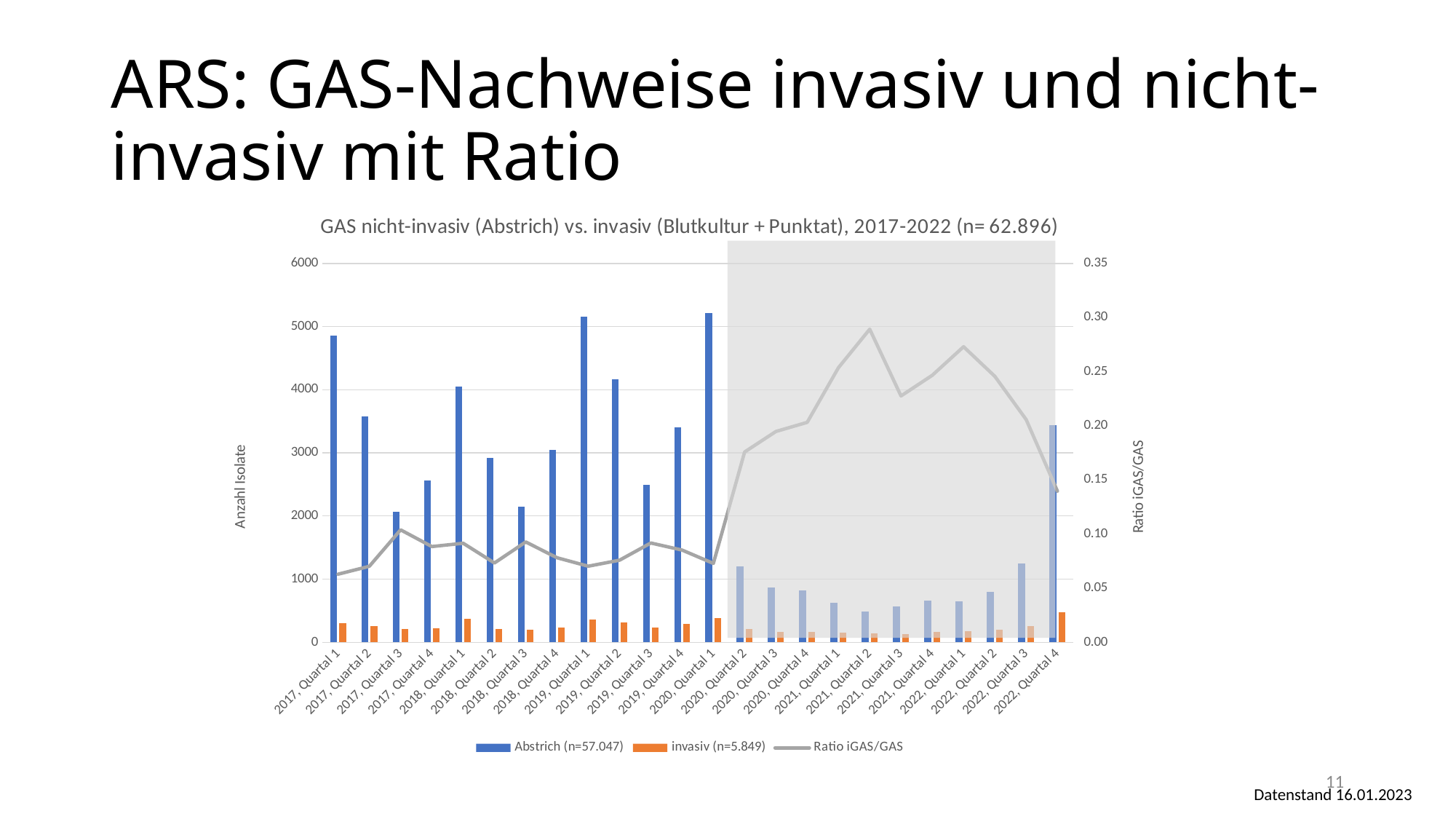
Is the Ratio iGAS/GAS value for 2021, Quartal 2 greater or less than 0.25? greater In which quarter is the Ratio iGAS/GAS line at its highest? 2021, Quartal 2 Is the Abstrich value for 2017, Quartal 1 greater or less than 4000? greater Which has the larger Abstrich value, 2017, Quartal 1 or 2017, Quartal 2? 2017, Quartal 1 What kind of chart is shown on the slide? A combined bar and line chart How many series does the legend list? 3 What is the label of the right-hand y axis? Ratio iGAS/GAS In which quarter is the Ratio iGAS/GAS line at its lowest? 2017, Quartal 1 In which quarter is the Abstrich bar the lowest? 2021, Quartal 2 How many quarters are shown on the x axis? 24 Does the Ratio iGAS/GAS line rise or fall from 2020, Quartal 1 to 2021, Quartal 2? rise Is the Ratio iGAS/GAS value for 2017, Quartal 1 greater or less than 0.10? less